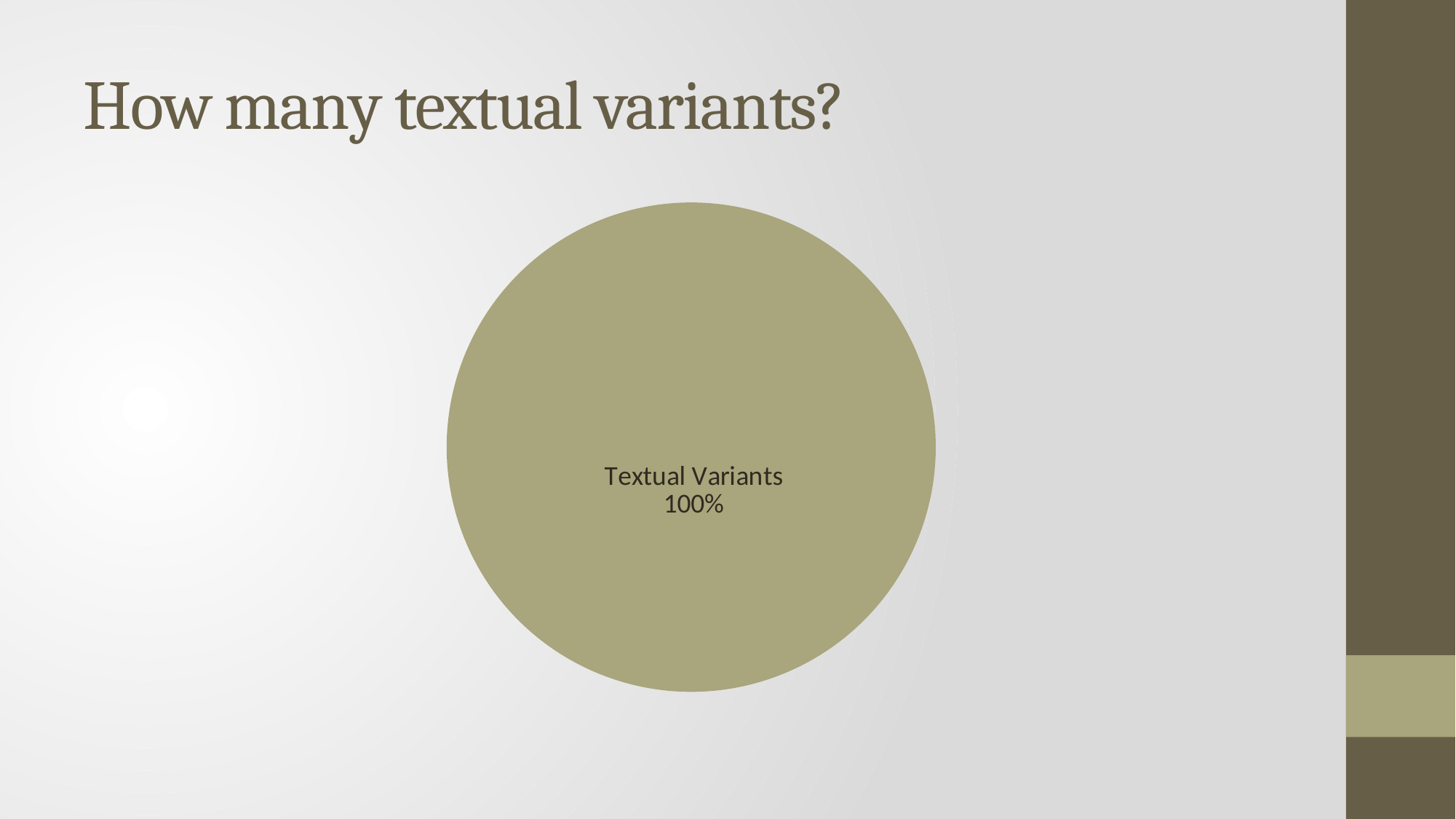
What share of the pie does the Textual Variants slice take up? 100% What is the label of the only slice in the pie chart? Textual Variants How many slices does the pie chart have? 1 What kind of chart is shown on the slide? pie chart What is the title of the slide containing the pie chart? How many textual variants? Is the share shown for Textual Variants greater or less than 50%? greater